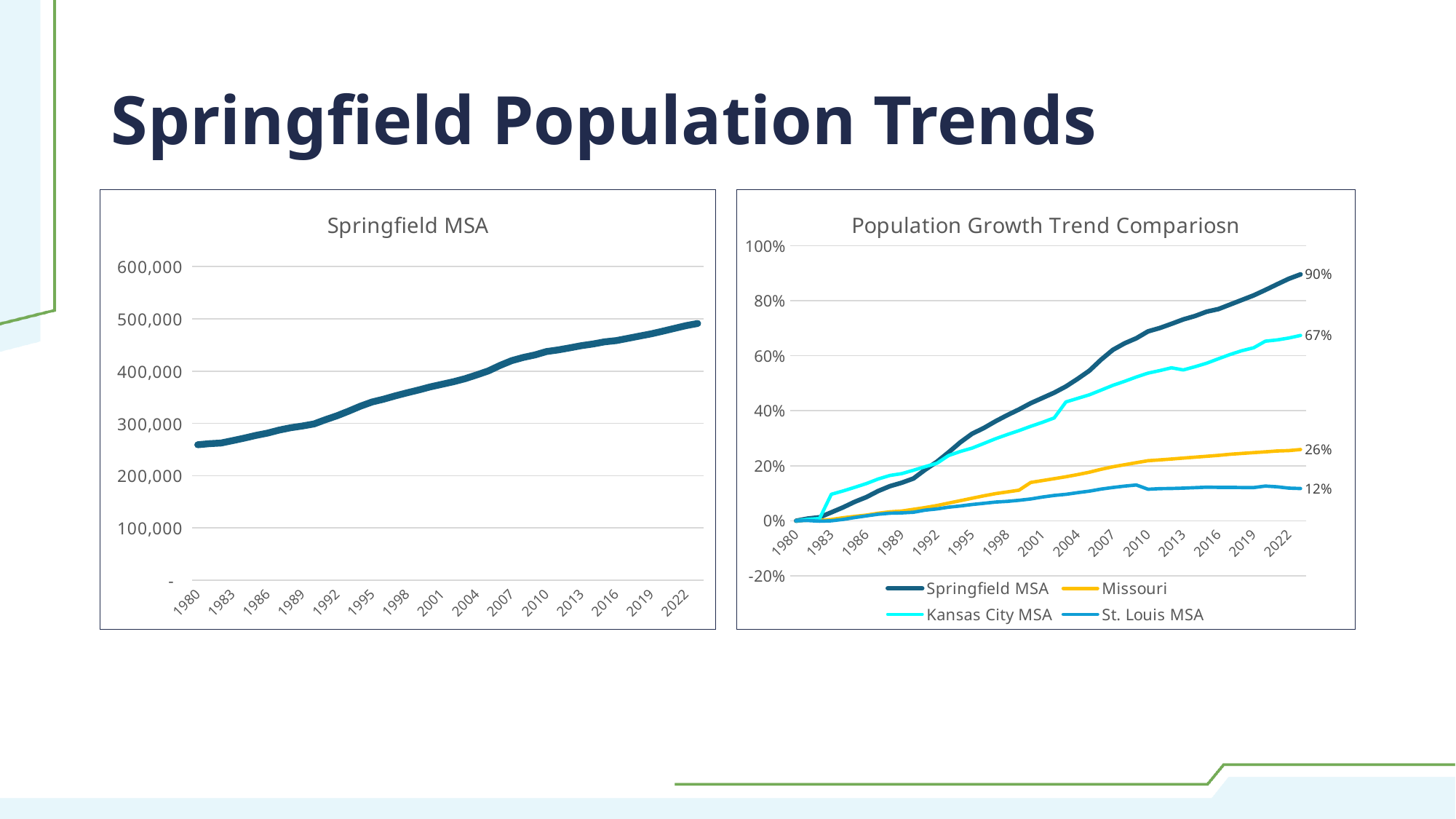
In the Springfield MSA chart on the left, do the values rise or fall from 1980 to 2022? Rise In the Population Growth Trend Comparison chart, what is the final labelled growth value for Kansas City MSA? 67% In the Population Growth Trend Comparison chart, which series has the lowest growth at the end of the period? St. Louis MSA In the Population Growth Trend Comparison chart, what is the final labelled growth value for Springfield MSA? 90% In the Population Growth Trend Comparison chart, what is the final labelled growth value for Missouri? 26% In the Population Growth Trend Comparison chart, what is the difference between the final growth values of Springfield MSA and Kansas City MSA? 23 percentage points In the Population Growth Trend Comparison chart, which has the larger final growth value, Missouri or St. Louis MSA? Missouri What kind of chart is the Springfield MSA chart on the left? Line chart In the Population Growth Trend Comparison chart, which series has the highest growth at the end of the period? Springfield MSA In the Population Growth Trend Comparison chart, what is the final labelled growth value for St. Louis MSA? 12% In the Springfield MSA chart on the left, is the value for 2022 greater or less than 400,000? greater How many series does the legend of the Population Growth Trend Comparison chart list? 4